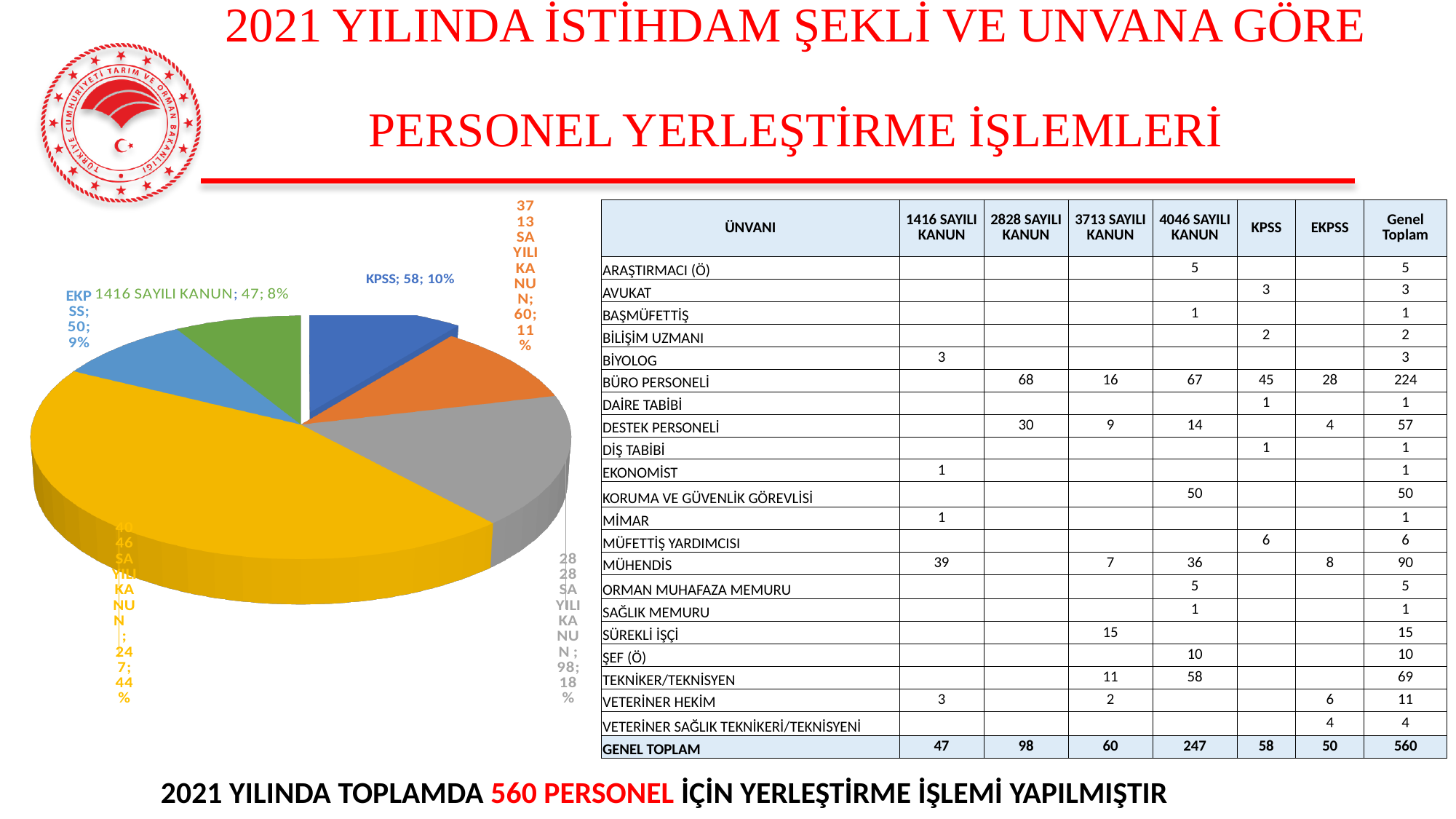
What value is shown for KPSS in the pie chart? 58 What kind of chart is shown on the left of the slide? pie chart Which category has the largest slice in the pie chart? 4046 SAYILI KANUN How many slices does the pie chart have? 6 What percentage share does the 4046 SAYILI KANUN slice have in the pie chart? 44% What colour is the 4046 SAYILI KANUN slice in the pie chart? yellow Which category has the smallest slice in the pie chart? 1416 SAYILI KANUN What percentage share does the EKPSS slice have in the pie chart? 9% In the pie chart, which is larger: the value for 3713 SAYILI KANUN or the value for KPSS? 3713 SAYILI KANUN In the pie chart, what is the difference between the values for 4046 SAYILI KANUN and 2828 SAYILI KANUN? 149 What value is shown for 2828 SAYILI KANUN in the pie chart? 98 What percentage share does the 1416 SAYILI KANUN slice have in the pie chart? 8%